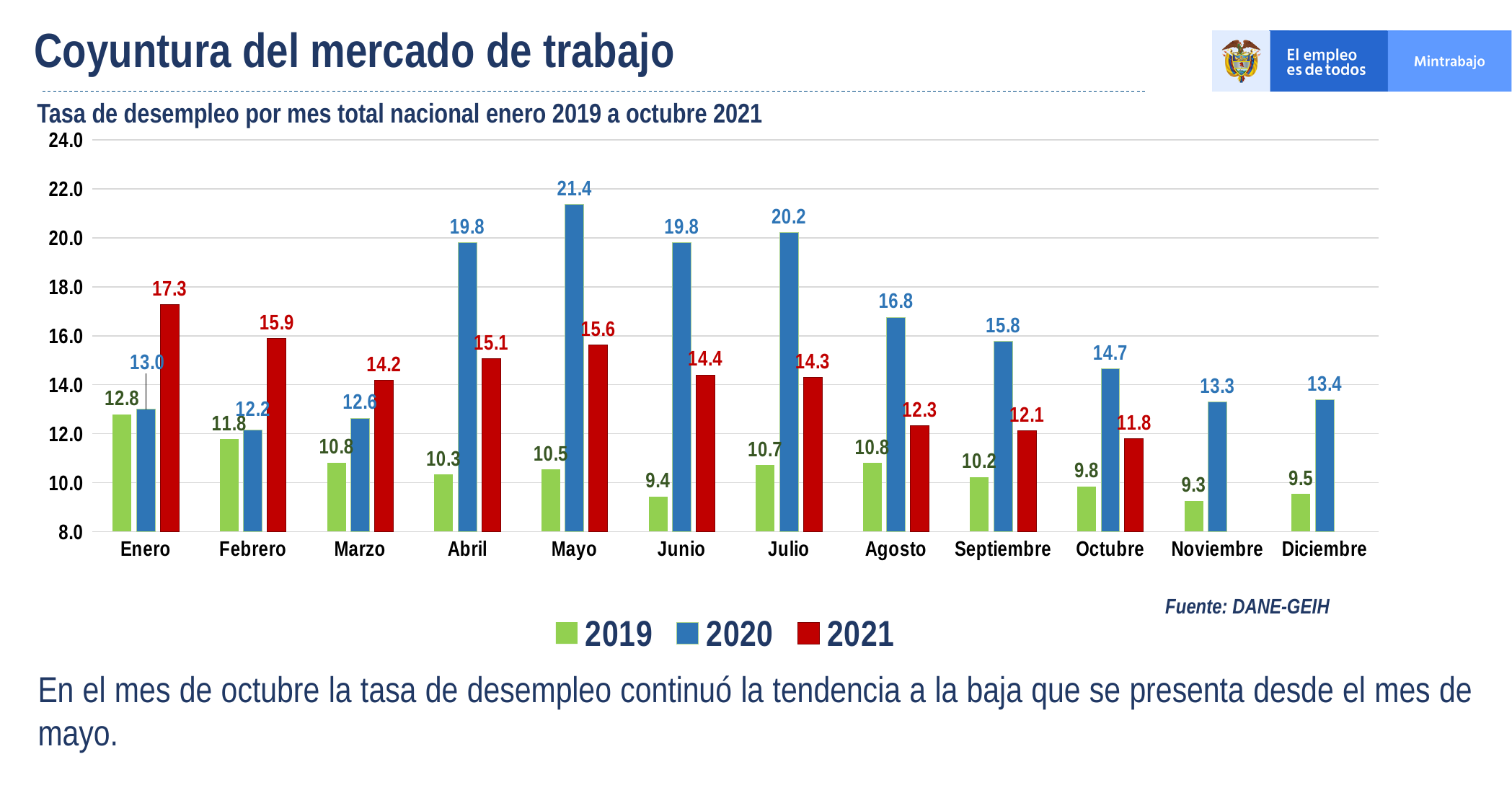
Which month has the highest 2020 value? Mayo How many months are shown on the x axis? 12 Which month has the lowest 2019 value? Noviembre What is the difference between the 2020 and 2021 values for Abril? 4.7 How many series does the legend list? 3 What is the 2019 unemployment rate for Junio? 9.4 Do the 2021 values rise or fall from Mayo to Octubre? fall What kind of chart is shown? bar chart Is the 2020 value for Julio greater or less than 20.0? greater What is the 2020 unemployment rate for Mayo? 21.4 What is the 2021 unemployment rate for Octubre? 11.8 Which is larger, the 2021 value for Enero or the 2020 value for Enero? 2021 value for Enero